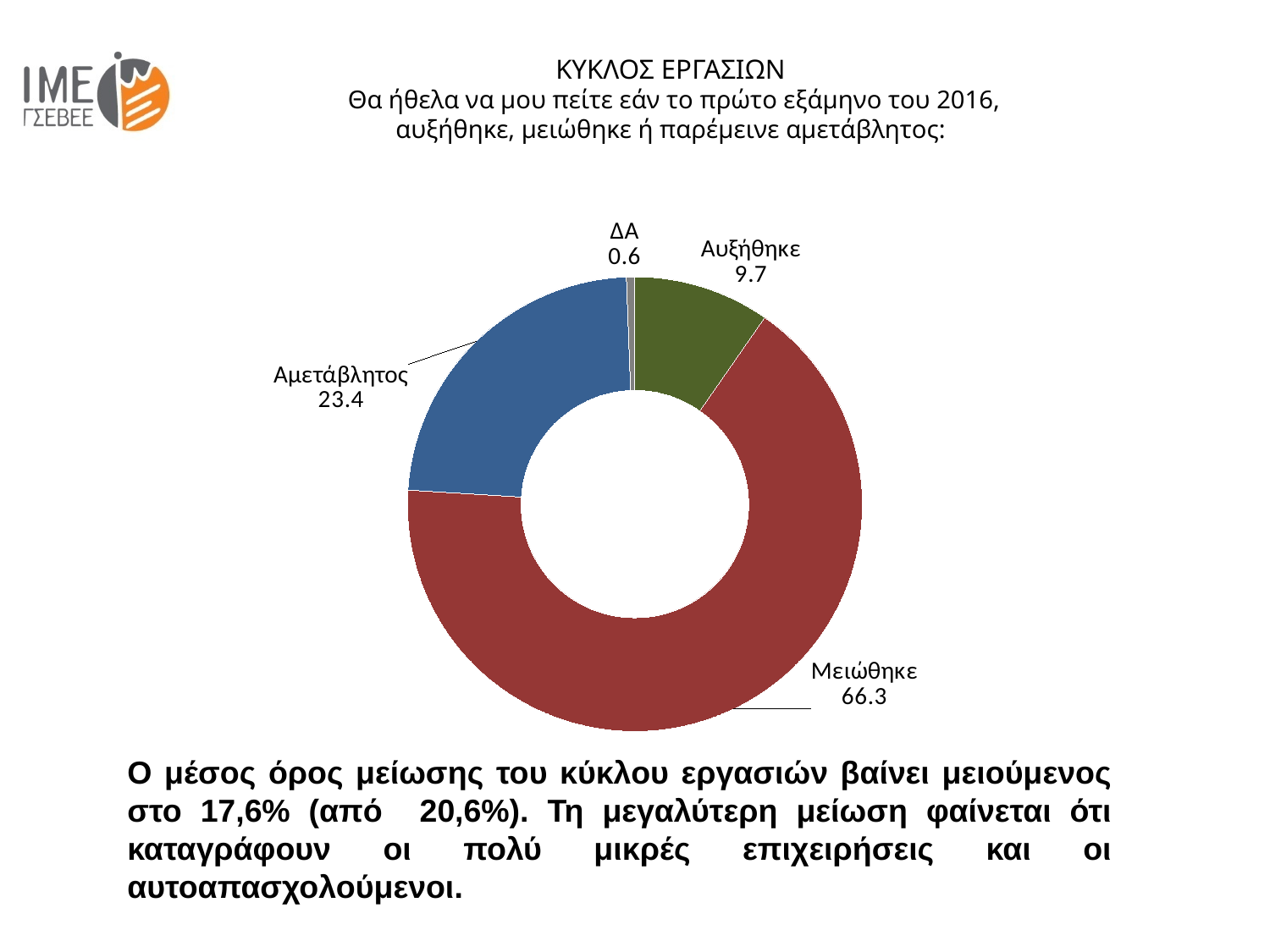
What value is shown for Μειώθηκε? 66.3 What value is shown for Αυξήθηκε? 9.7 What value is shown for ΔΑ? 0.6 Which category has the smallest value? ΔΑ What is the difference between the values for Αμετάβλητος and Αυξήθηκε? 13.7 Which category has the largest value? Μειώθηκε What value is shown for Αμετάβλητος? 23.4 What is the difference between the values for Μειώθηκε and Αμετάβλητος? 42.9 How many categories are shown in the chart? 4 What is the title of the chart? ΚΥΚΛΟΣ ΕΡΓΑΣΙΩΝ What kind of chart is shown on the slide? Doughnut (pie) chart Which is larger, the value for Αυξήθηκε or the value for Αμετάβλητος? Αμετάβλητος